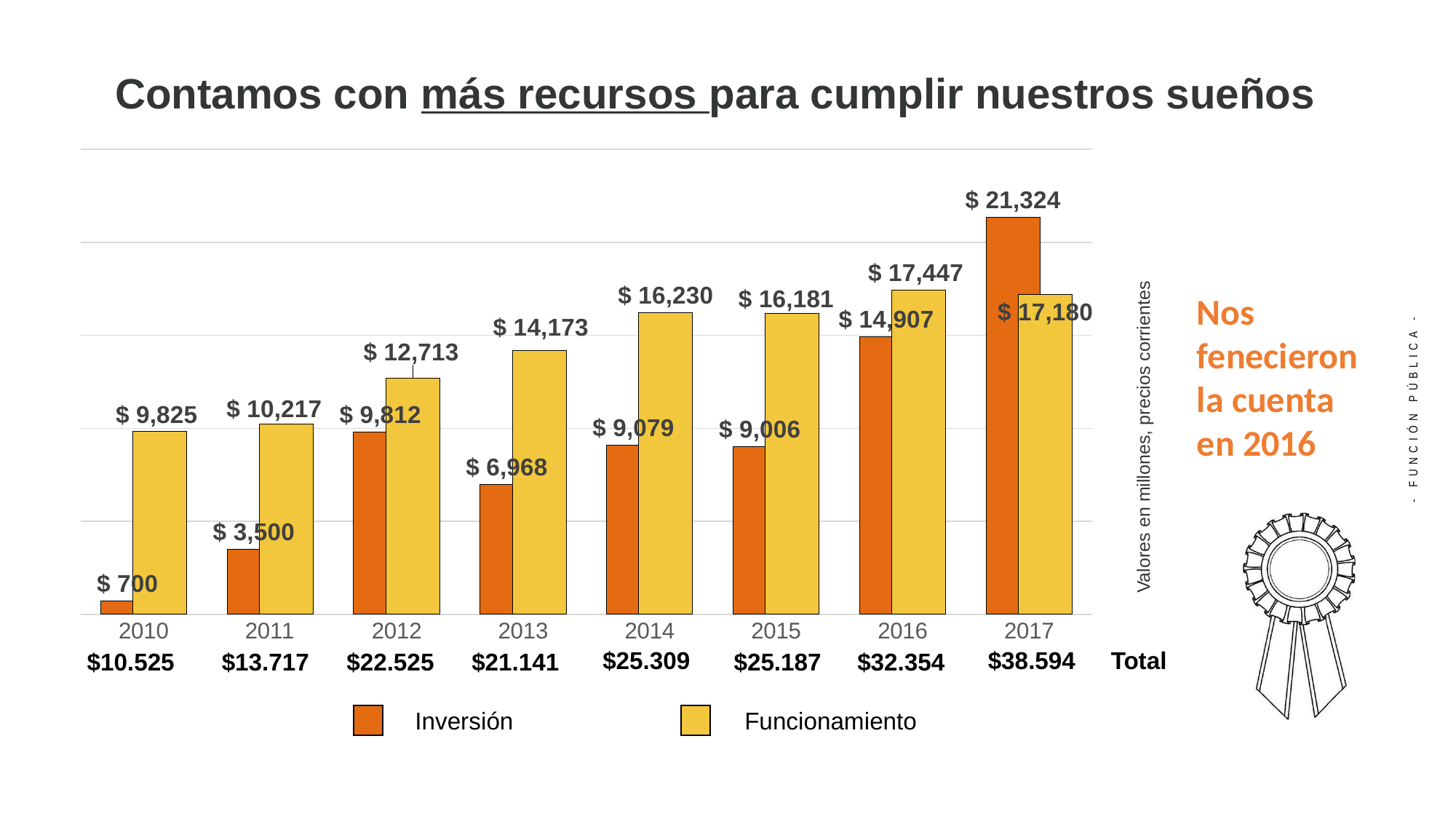
In which year is Inversión lowest? 2010 What does the vertical axis label say the values are measured in? Valores en millones, precios corrientes How many years are shown on the x axis? 8 What is the value of Inversión for 2017? $ 21,324 From 2010 to 2014, does Funcionamiento rise or fall? Rise What is the difference between Inversión and Funcionamiento in 2017? $ 4,144 In which year is Inversión highest? 2017 What is the value of Funcionamiento for 2014? $ 16,230 What kind of chart is shown on the slide? Bar chart How many series does the legend list? 2 In 2016, which is larger, Inversión or Funcionamiento? Funcionamiento What is the value of Inversión for 2010? $ 700